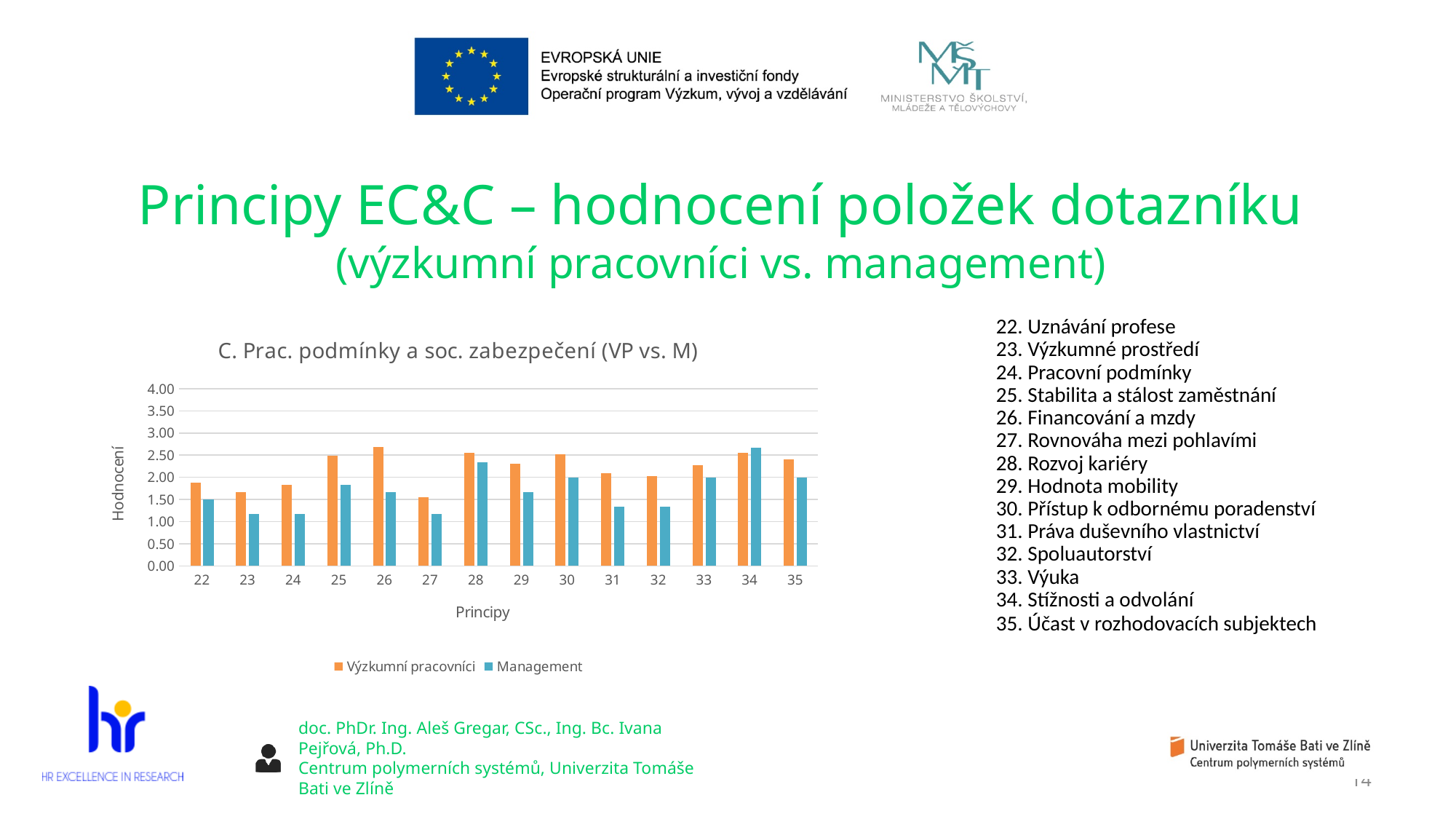
How many series does the chart legend list? 2 What is the title of the chart? C. Prac. podmínky a soc. zabezpečení (VP vs. M) Is the value for Výzkumní pracovníci at principle 26 greater or less than 2.50? greater How many categories (principy) are shown on the x axis of the chart? 14 At principle 22, which series has the larger value, Výzkumní pracovníci or Management? Výzkumní pracovníci For the Management series, which principle has the highest value? 34 What kind of chart is shown on the slide? bar chart What label is shown on the y axis of the chart? Hodnocení At principle 27, which series has the larger value, Výzkumní pracovníci or Management? Výzkumní pracovníci Is the value for Management at principle 28 greater or less than 2.00? greater Is the value for Management at principle 27 greater or less than 1.50? less